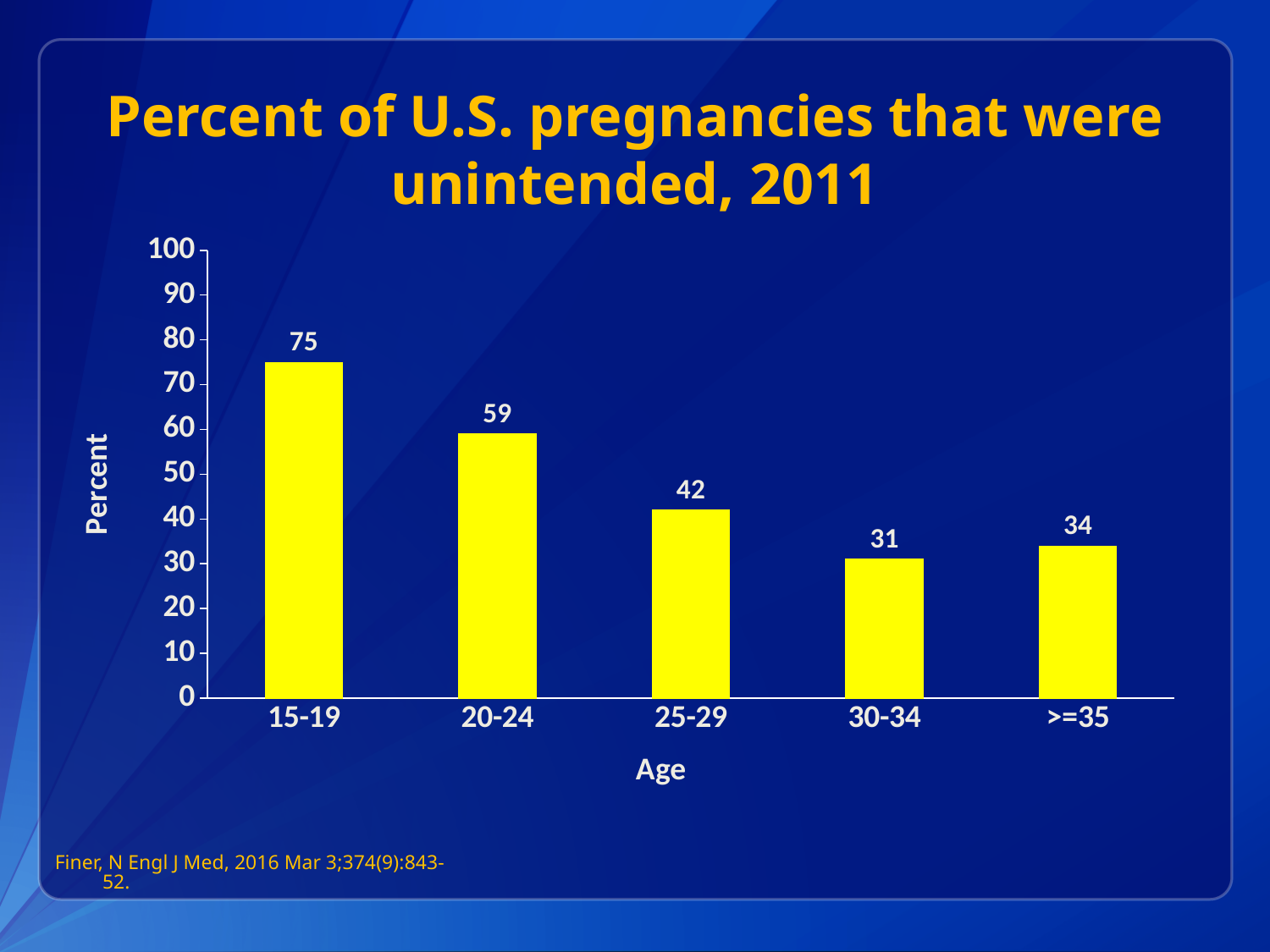
What is the difference in percent between the 15-19 and 20-24 age groups? 16 What is the percent of unintended pregnancies for the >=35 age group? 34 What is the percent of unintended pregnancies for the 30-34 age group? 31 Which age group has the highest percent of unintended pregnancies? 15-19 How many age groups are shown in the chart? 5 What is the percent of unintended pregnancies for the 15-19 age group? 75 Which age group has the lowest percent of unintended pregnancies? 30-34 What is the label of the x axis? Age Which age group has a higher percent of unintended pregnancies, 25-29 or >=35? 25-29 What kind of chart is shown on the slide? Bar chart What is the percent of unintended pregnancies for the 20-24 age group? 59 Is the value for the 25-29 age group greater or less than 50? less